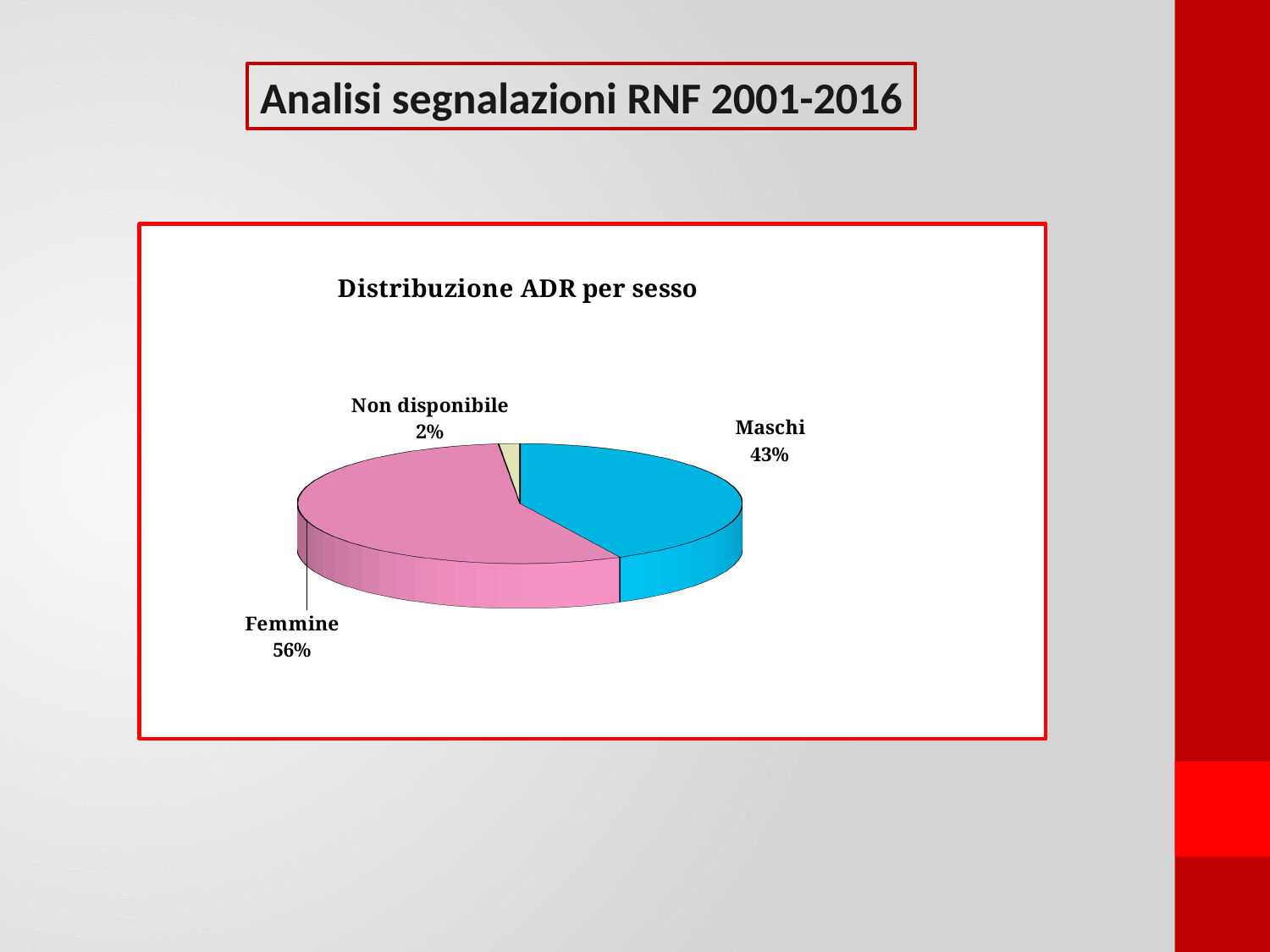
What is the share of the pie for Femmine? 56% What is the title of the chart? Distribuzione ADR per sesso Which category has the smallest share of the pie? Non disponibile What percentage of the pie is Non disponibile? 2% What is the difference in percentage points between Femmine and Maschi? 13 What percentage of the pie is Femmine? 56% Which category has the largest share of the pie? Femmine Which is larger, the share for Maschi or the share for Non disponibile? Maschi What colour is the Maschi slice? blue What percentage of the pie is Maschi? 43% How many slices does the pie chart have? 3 What type of chart is shown on the slide? pie chart